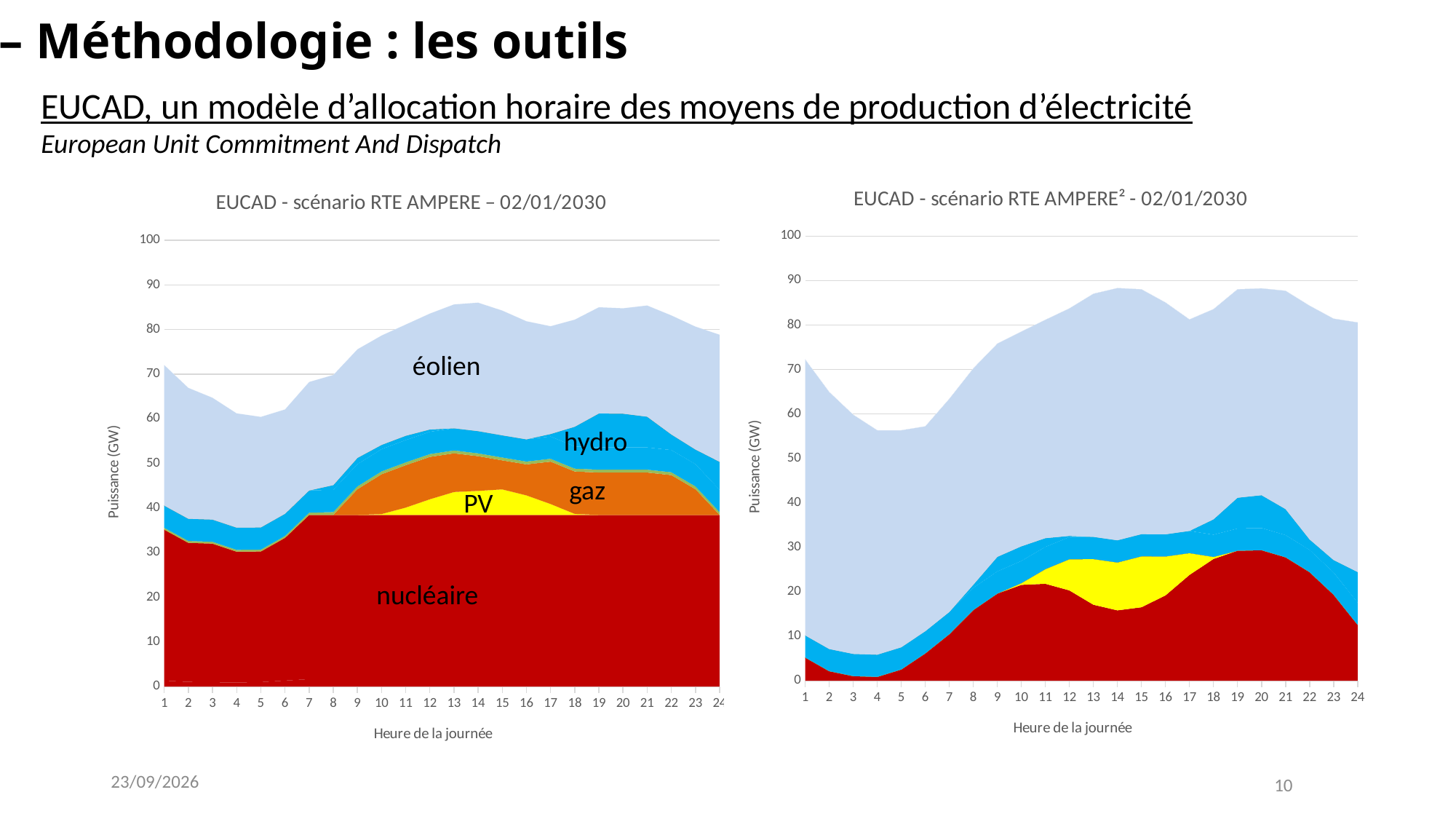
In the left chart, is the nucléaire value at hour 12 greater or less than 40? less In the left chart, how many production sources are labelled on the areas? 5 In the left chart, which production source forms the bottom (dark red) area? nucléaire In the right chart, does the total production rise or fall from hour 1 to hour 4? fall In the right chart, is the total production at hour 14 greater or less than 80? greater In the left chart, is the total production larger at hour 14 or at hour 5? hour 14 What kind of chart is the left chart titled "EUCAD - scénario RTE AMPERE – 02/01/2030"? Stacked area chart In the right chart, is the total production at hour 4 greater or less than 60? less In the left chart, what is the title of the vertical axis? Puissance (GW) In the left chart, how many hours are shown along the x axis? 24 In the left chart, does the nucléaire area rise or fall from hour 1 to hour 5? fall